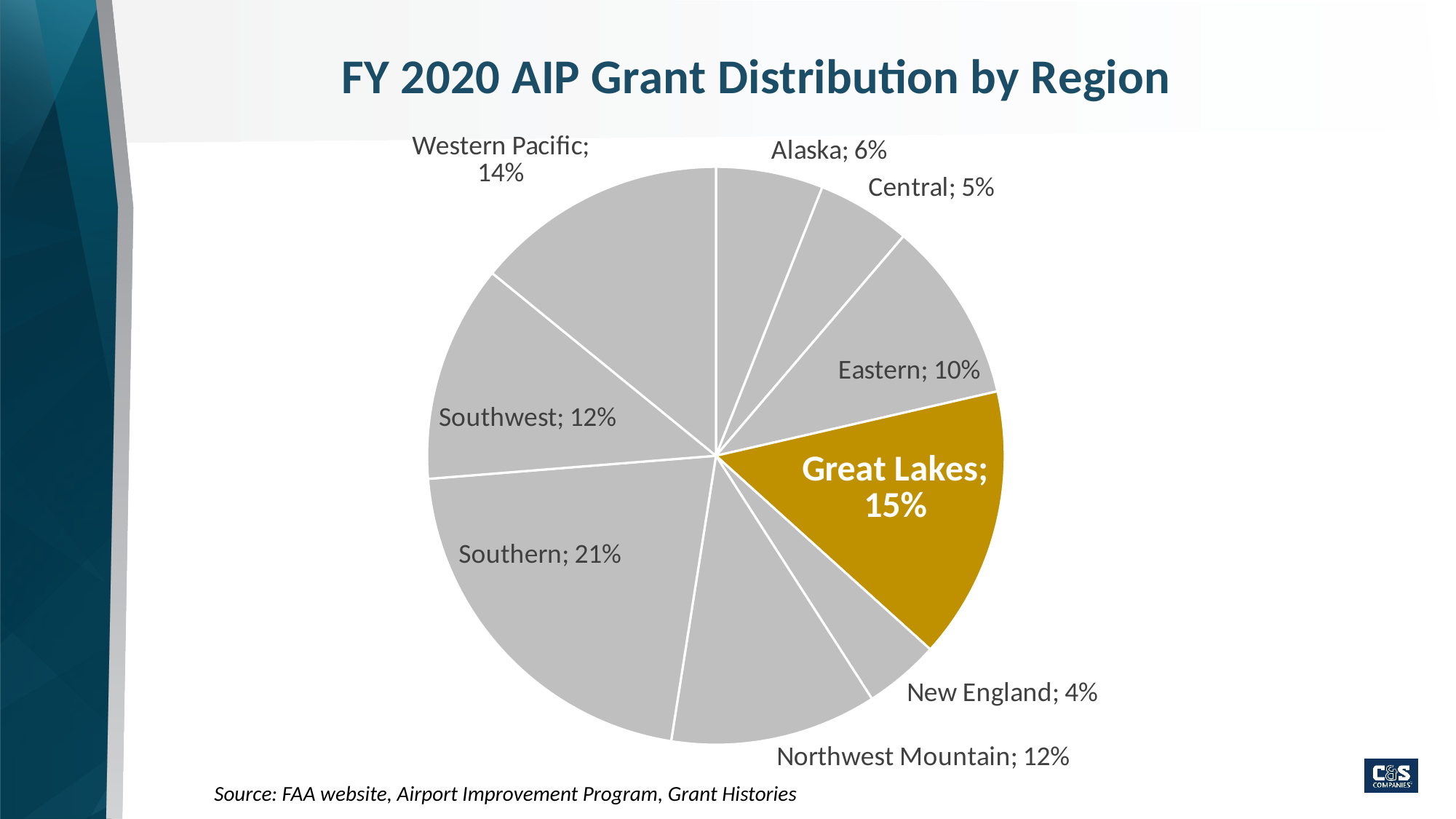
Which region has a larger share, Eastern or Alaska? Eastern Which region's slice is highlighted in gold? Great Lakes What is the difference in percentage points between the Southern and Great Lakes shares? 6 What type of chart is shown on the slide? Pie chart How many regions are shown in the pie chart? 9 Which region has the smallest share of FY 2020 AIP grants? New England What percentage is shown for the Southern region? 21% What is the combined share of the Alaska and Central regions? 11% What share of FY 2020 AIP grants went to the Great Lakes region? 15% Which region has the largest share of FY 2020 AIP grants? Southern What is the title of the chart? FY 2020 AIP Grant Distribution by Region What share is shown for the Western Pacific region? 14%